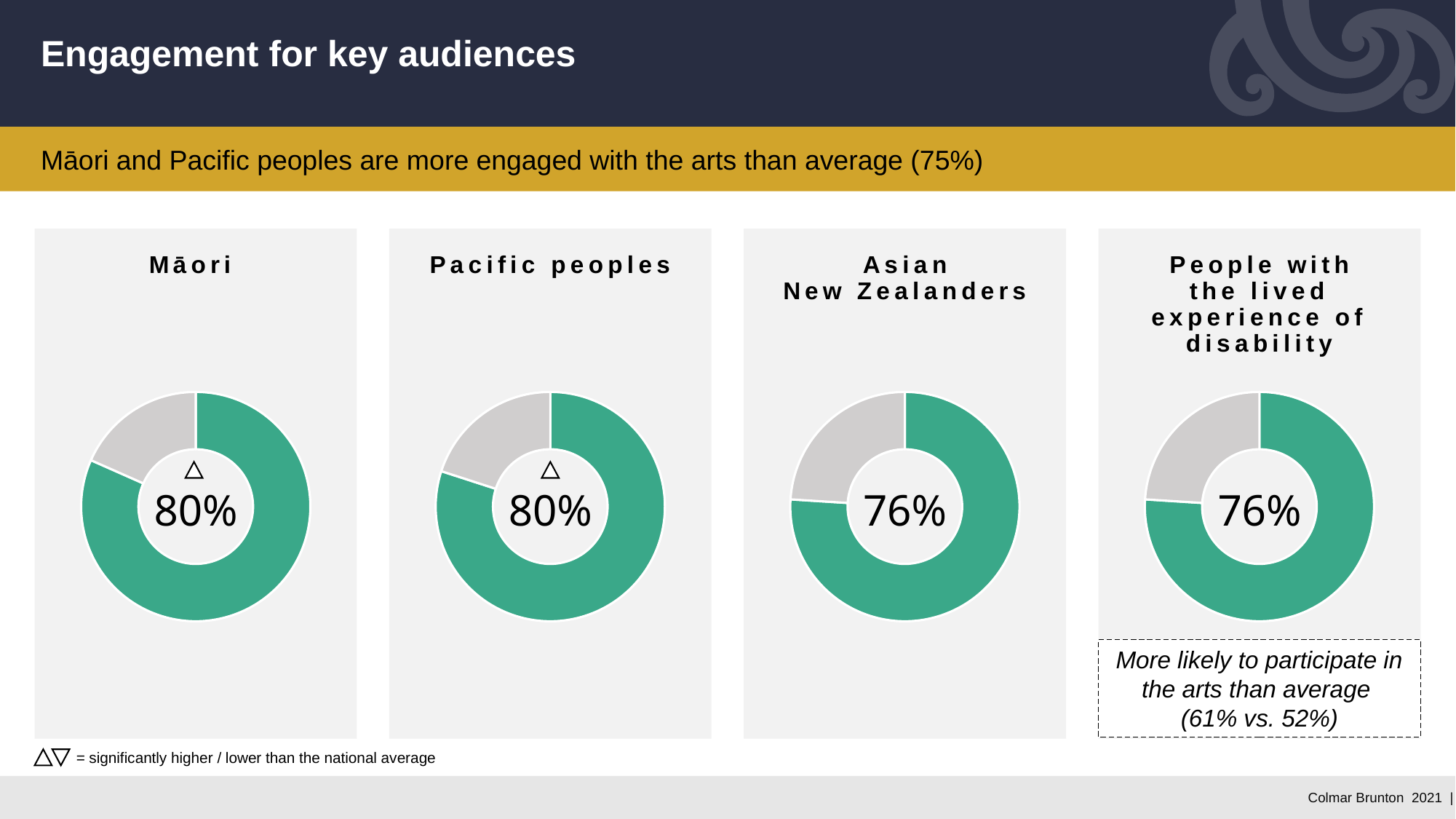
How many donut charts are shown on the slide? 4 In the People with the lived experience of disability chart, what percentage is shown? 76% What kind of chart is used for each of the four audience groups on this slide? Donut chart Which two groups share the highest engagement value on the slide? Māori and Pacific peoples Which is larger, the value in the Māori chart or the value in the Asian New Zealanders chart? Māori Which charts on the slide display a triangle symbol above the percentage? Māori and Pacific peoples In the Māori chart, what percentage is shown in the centre of the donut? 80% In the Pacific peoples chart, what value is displayed? 80% In the Māori chart, what share of the donut does the green segment represent? 80% In the Asian New Zealanders chart, what percentage is shown? 76% According to the footnote, what does the triangle symbol indicate? Significantly higher / lower than the national average What is the difference between the Pacific peoples value and the People with the lived experience of disability value? 4 percentage points